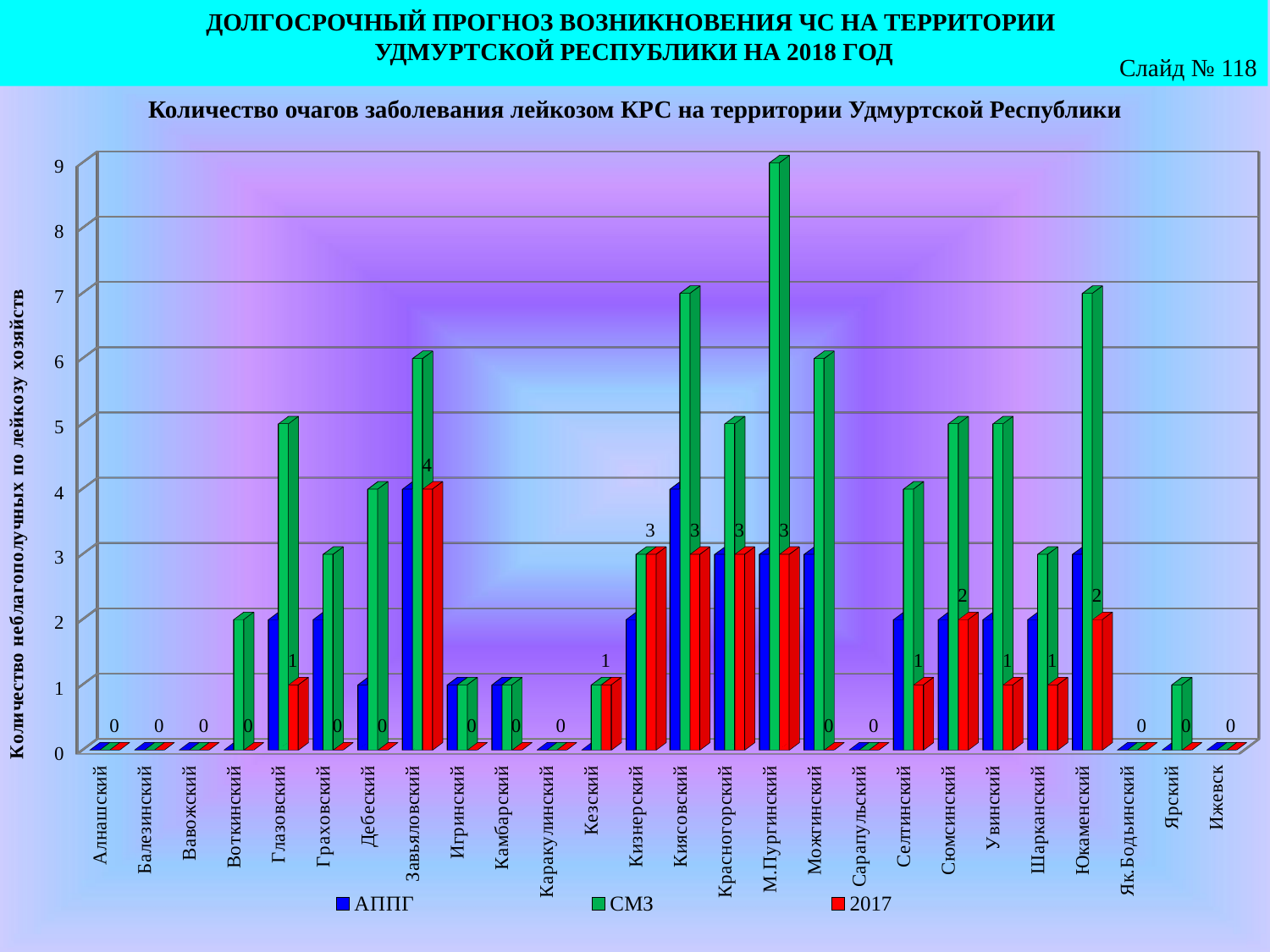
How many categories are shown on the x axis? 26 How many series does the legend list? 3 Which is larger, the 2017 value for Кизнерский or for Глазовский? Кизнерский Is the СМЗ value for Киясовский greater or less than 6? greater What is the 2017 value for Сюмсинский? 2 What kind of chart is shown? bar chart What is the difference between the 2017 values for Завьяловский and Сюмсинский? 2 Is the СМЗ value for Ярский greater or less than 2? less Which category has the highest СМЗ value? М.Пургинский What is the 2017 value for Завьяловский? 4 What is the 2017 value for Кизнерский? 3 Which category has the highest 2017 value? Завьяловский